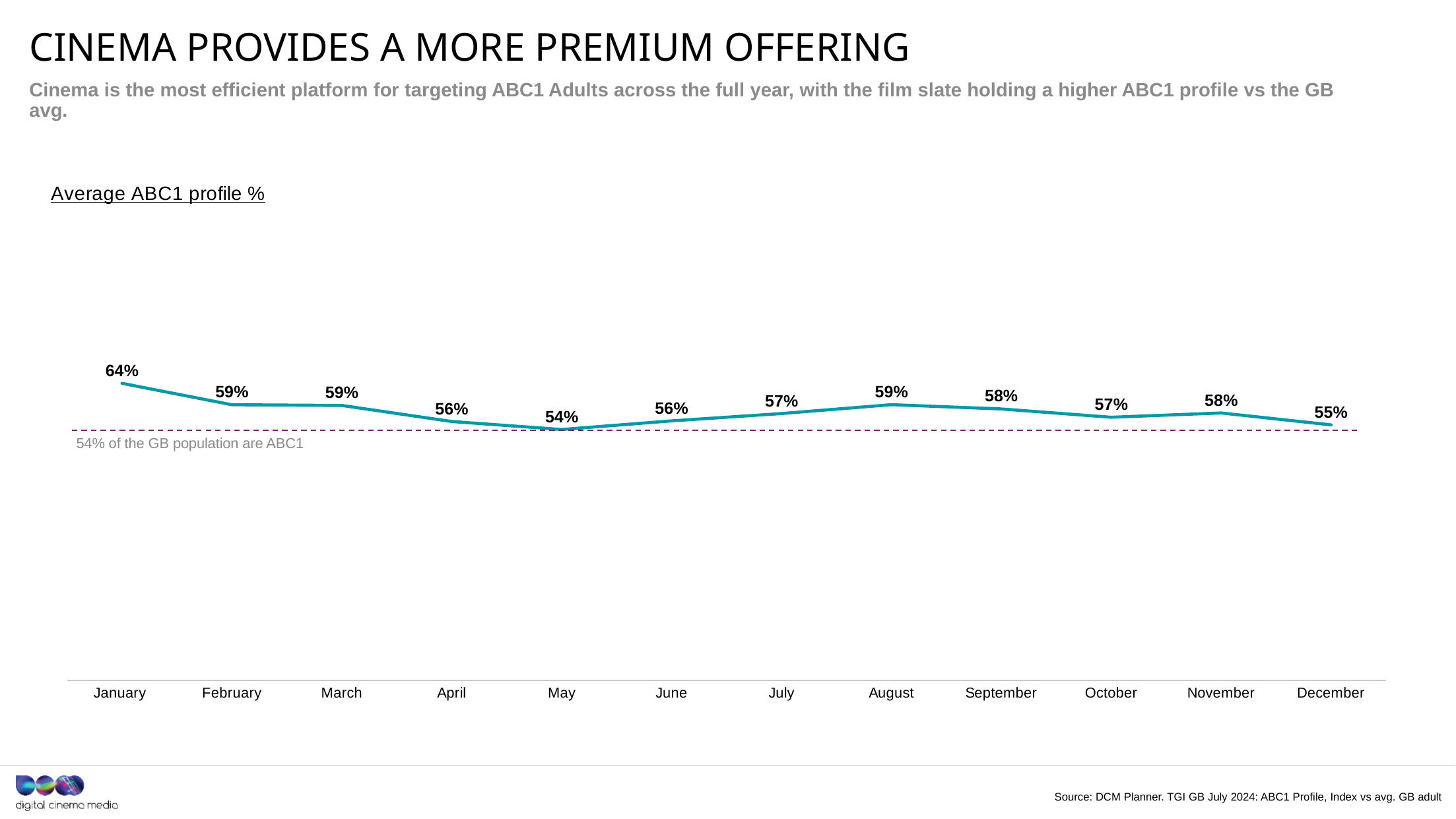
What is the average ABC1 profile % for August? 59% What kind of chart is shown on the slide? Line chart What is the average ABC1 profile % for May? 54% What is the difference between the January and May average ABC1 profile % values? 10% What is the average ABC1 profile % for January? 64% What is the average ABC1 profile % for December? 55% Which month has a higher average ABC1 profile %, September or October? September What percentage of the GB population is ABC1, according to the dashed reference line? 54% Which month has the highest average ABC1 profile %? January How many months are plotted on the chart? 12 Which month has the lowest average ABC1 profile %? May Does the average ABC1 profile % rise or fall from January to May? Fall